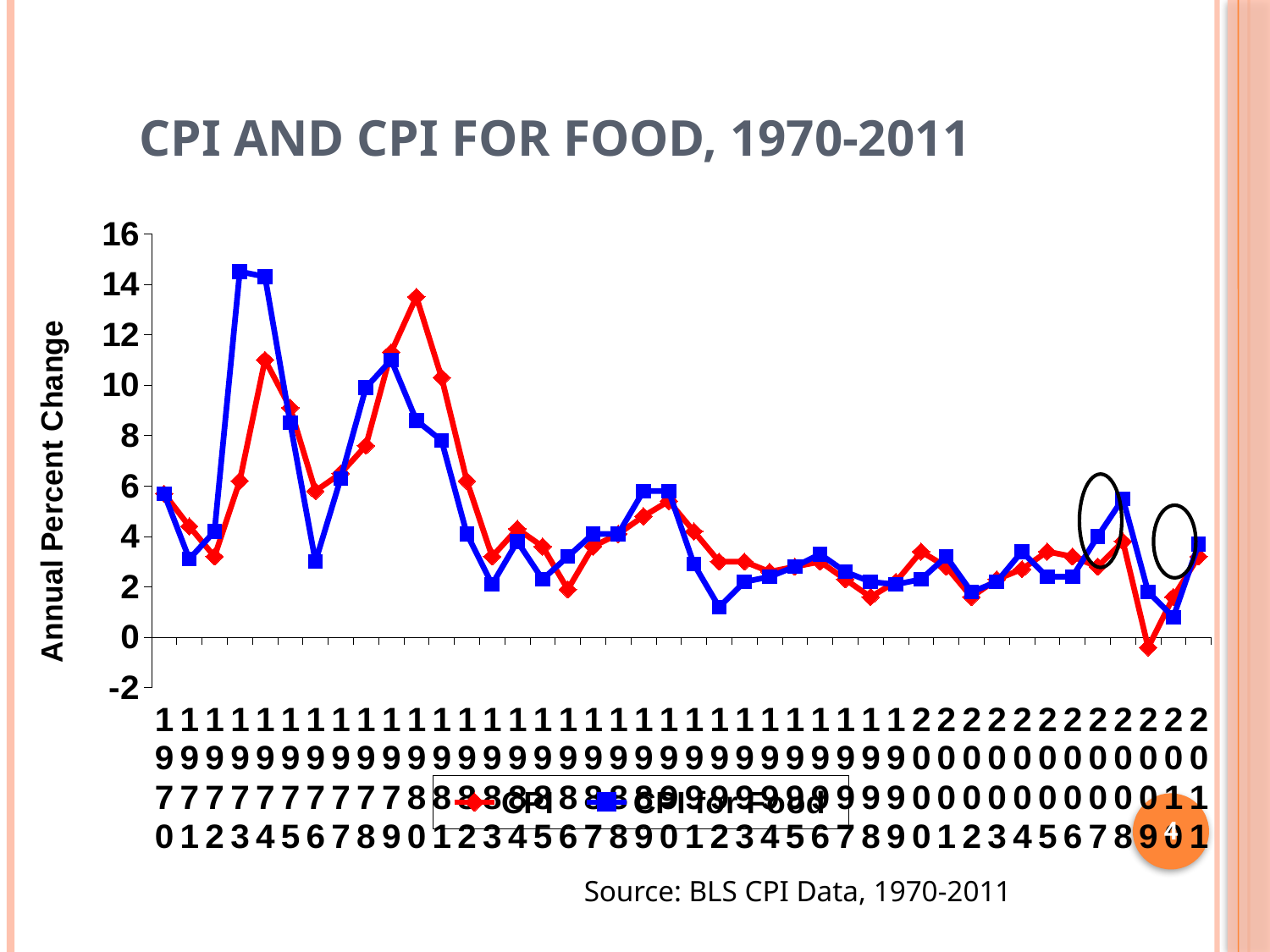
How many years are plotted along the x axis? 42 Is the CPI for Food value for 1973 greater or less than 12? greater In which year does the CPI series reach its lowest value? 2009 In which year does the CPI series reach its highest value? 1980 What are the two series named in the legend? CPI and CPI for Food What kind of chart is shown on the slide? Line chart Is the CPI value for 1980 greater or less than 12? greater How many series does the legend list? 2 In 1973, which series has the higher value, CPI or CPI for Food? CPI for Food What is the label on the vertical axis? Annual Percent Change In 1980, which series has the higher value, CPI or CPI for Food? CPI Is the CPI value for 2009 greater or less than 0? less